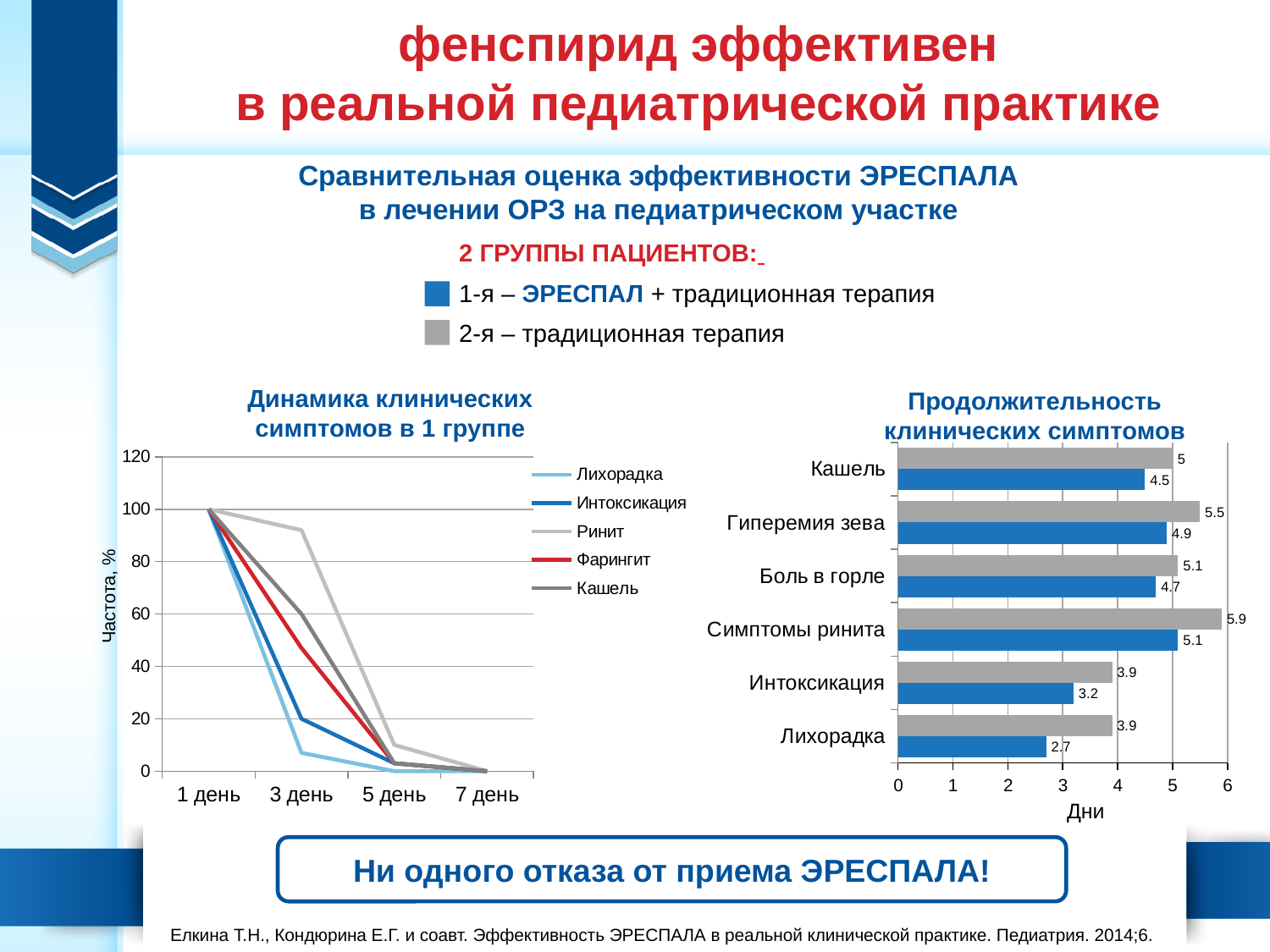
In the chart "Продолжительность клинических симптомов", which is larger for Интоксикация: the gray bar or the blue bar? the gray bar In the chart "Продолжительность клинических симптомов", what is the value of the blue bar for Лихорадка? 2.7 How many series does the legend of the chart "Динамика клинических симптомов в 1 группе" list? 5 In the chart "Динамика клинических симптомов в 1 группе", do the values rise or fall from 1 день to 7 день? fall In the chart "Продолжительность клинических симптомов", which category has the lowest blue bar value? Лихорадка What kind of chart is the chart titled "Динамика клинических симптомов в 1 группе"? line chart In the chart "Динамика клинических симптомов в 1 группе", is the value for Лихорадка on 3 день greater or less than 20? less How many categories are shown in the chart "Продолжительность клинических симптомов"? 6 What kind of chart is the chart titled "Продолжительность клинических симптомов"? bar chart In the chart "Продолжительность клинических симптомов", what is the value of the gray bar for Симптомы ринита? 5.9 In the chart "Продолжительность клинических симптомов", what is the difference between the gray and blue bars for Лихорадка? 1.2 In the chart "Продолжительность клинических симптомов", which category has the highest gray bar value? Симптомы ринита